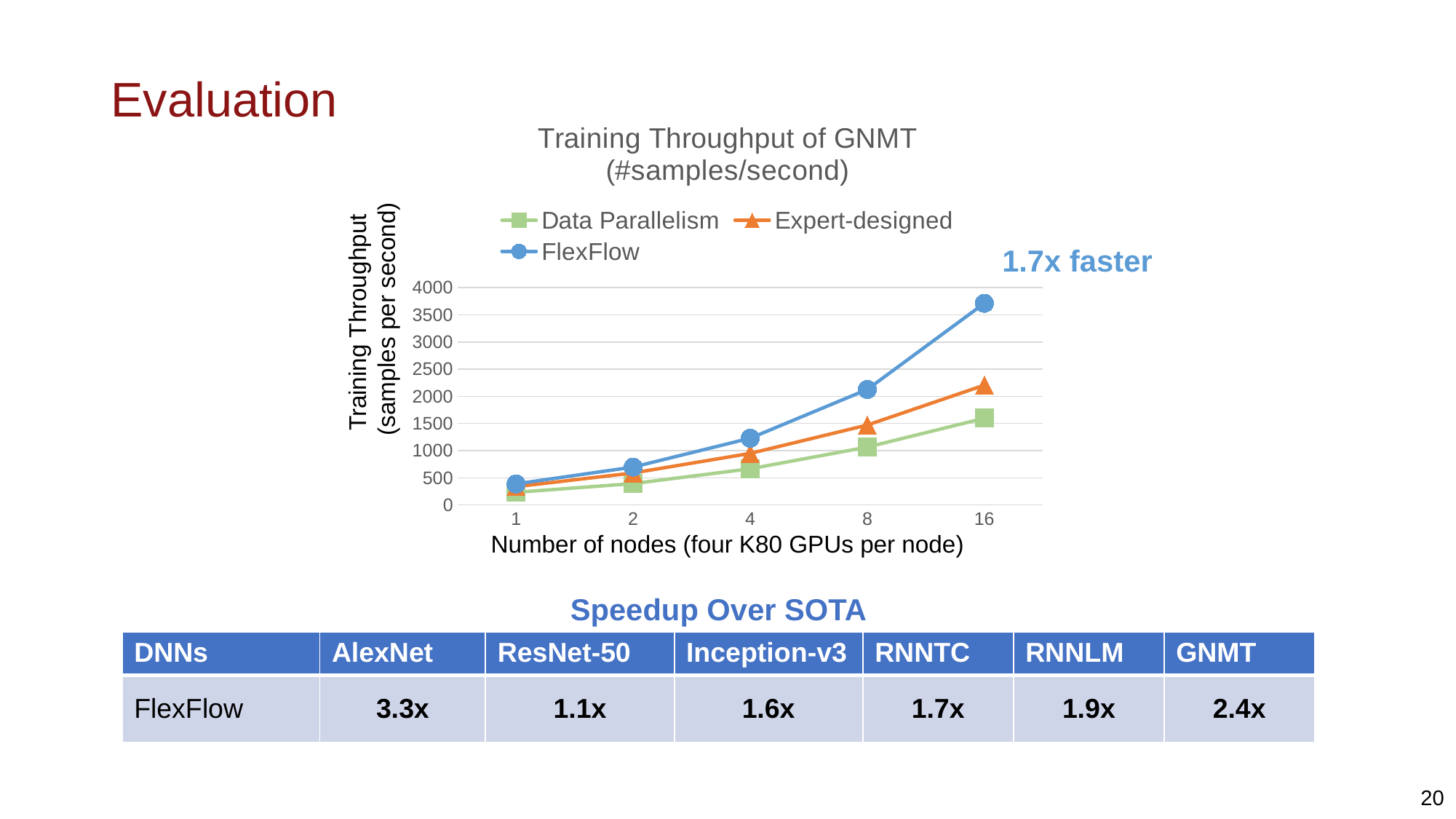
How many node counts are plotted along the x axis of the Training Throughput of GNMT chart? 5 Is the Data Parallelism training throughput at 16 nodes greater or less than 2000? less Is the FlexFlow training throughput at 8 nodes greater or less than 2000? greater How many series does the legend of the Training Throughput of GNMT chart list? 3 At 4 nodes, which has the higher training throughput, FlexFlow or Data Parallelism? FlexFlow What kind of chart is used to show the Training Throughput of GNMT? line chart Which series has the lowest training throughput at 16 nodes? Data Parallelism Is the FlexFlow training throughput at 16 nodes greater or less than 3500? greater Which series has the highest training throughput at 16 nodes? FlexFlow Does the FlexFlow training throughput rise or fall as the number of nodes increases? rise What is the x-axis label of the Training Throughput of GNMT chart? Number of nodes (four K80 GPUs per node)